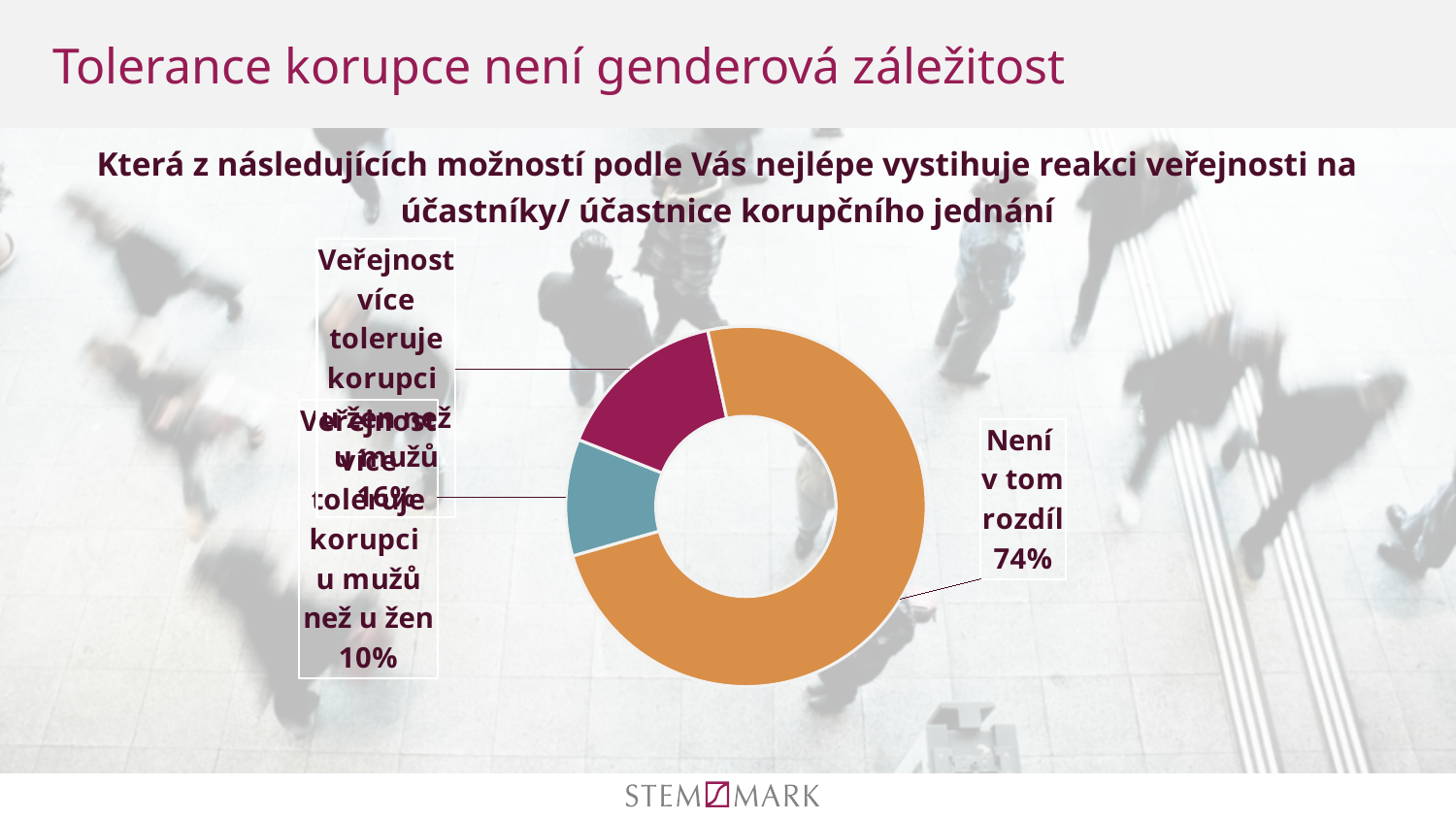
What is the difference in percentage points between "Není v tom rozdíl" (74%) and "Veřejnost více toleruje korupci u mužů než u žen" (10%)? 64 percentage points Which is larger: "Není v tom rozdíl" or "Veřejnost více toleruje korupci u mužů než u žen"? Není v tom rozdíl What is the title of the slide? Tolerance korupce není genderová záležitost Which category has the largest slice of the chart? Není v tom rozdíl Is the share for "Není v tom rozdíl" greater or less than 50%? greater What percentage is shown for "Veřejnost více toleruje korupci u mužů než u žen"? 10% What share of the chart does the "Není v tom rozdíl" slice represent? 74% What colour is the largest slice of the chart? Orange Which category has the smallest slice of the chart? Veřejnost více toleruje korupci u mužů než u žen What kind of chart is shown on the slide? A donut (pie) chart How many slices does the chart have? 3 What percentage is shown for "Není v tom rozdíl"? 74%